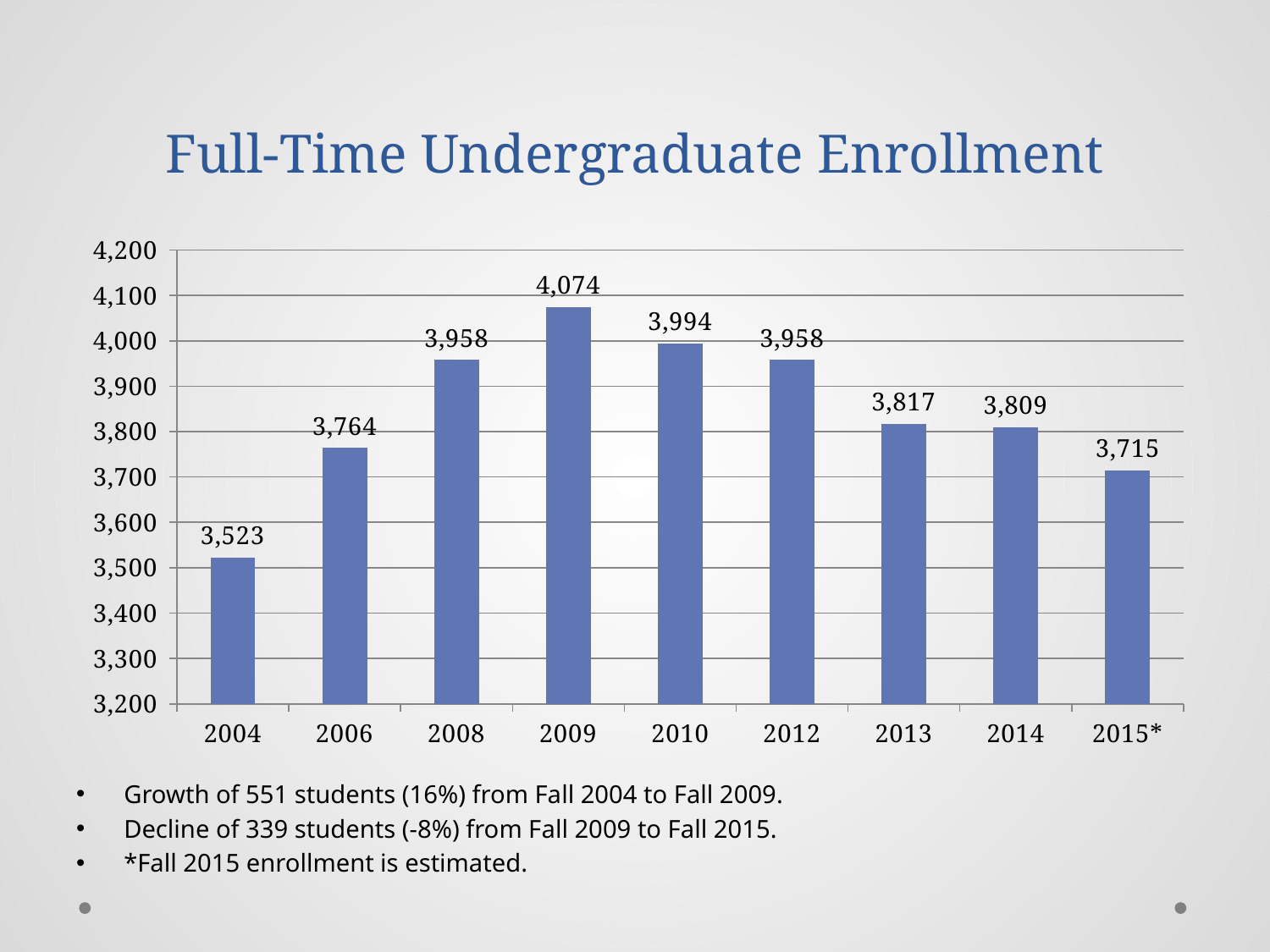
Does enrollment rise or fall from 2009 to 2015*? Fall What is the difference in enrollment between 2009 and 2004? 551 What is the full-time undergraduate enrollment for 2015*? 3,715 Which year has higher enrollment, 2006 or 2013? 2013 What is the difference in enrollment between 2013 and 2014? 8 What is the full-time undergraduate enrollment for 2010? 3,994 Which year has the lowest full-time undergraduate enrollment? 2004 Which year has the highest full-time undergraduate enrollment? 2009 How many years are shown on the x axis of the chart? 9 Is the enrollment for 2012 greater or less than 3,900? greater What kind of chart is shown on the slide? Bar chart What is the full-time undergraduate enrollment for 2004? 3,523